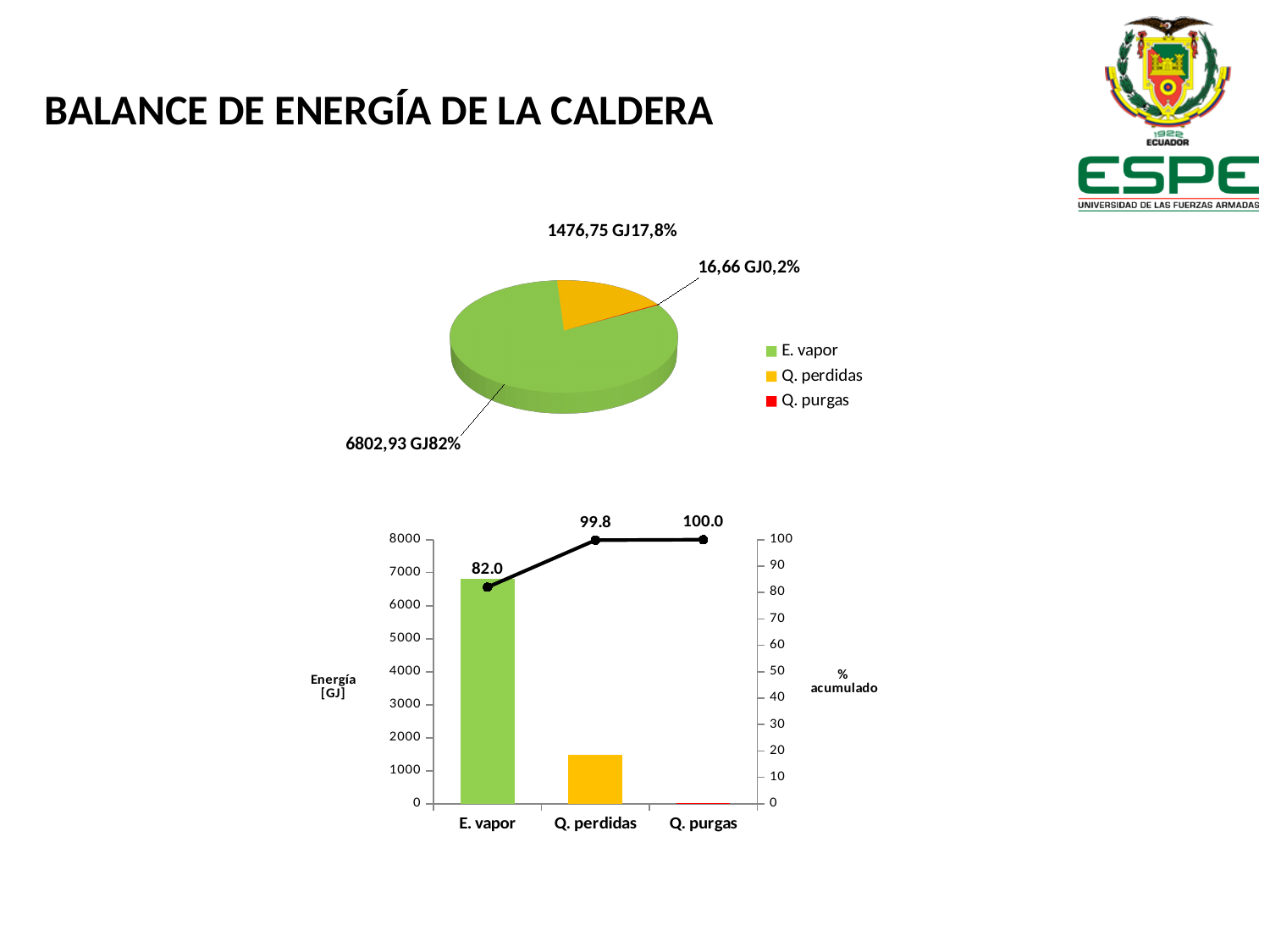
In the bottom chart, does the % acumulado line rise or fall from E. vapor to Q. purgas? rise In the pie chart, what share of the total does Q. purgas represent? 0,2% In the bottom chart, what is the % acumulado value for Q. perdidas? 99.8 In the bottom chart, is the Energía [GJ] bar for E. vapor greater or less than 6000? greater In the bottom chart, is the Energía [GJ] bar for Q. perdidas greater or less than 2000? less In the pie chart, which category has the largest slice? E. vapor In the pie chart, what value is labelled for Q. perdidas? 1476,75 GJ In the pie chart, which category has the smallest slice? Q. purgas How many categories are shown on the x axis of the bottom chart? 3 In the bottom chart, what is the % acumulado value for E. vapor? 82.0 In the pie chart, what share of the total does E. vapor represent? 82% How many entries does the legend of the pie chart list? 3